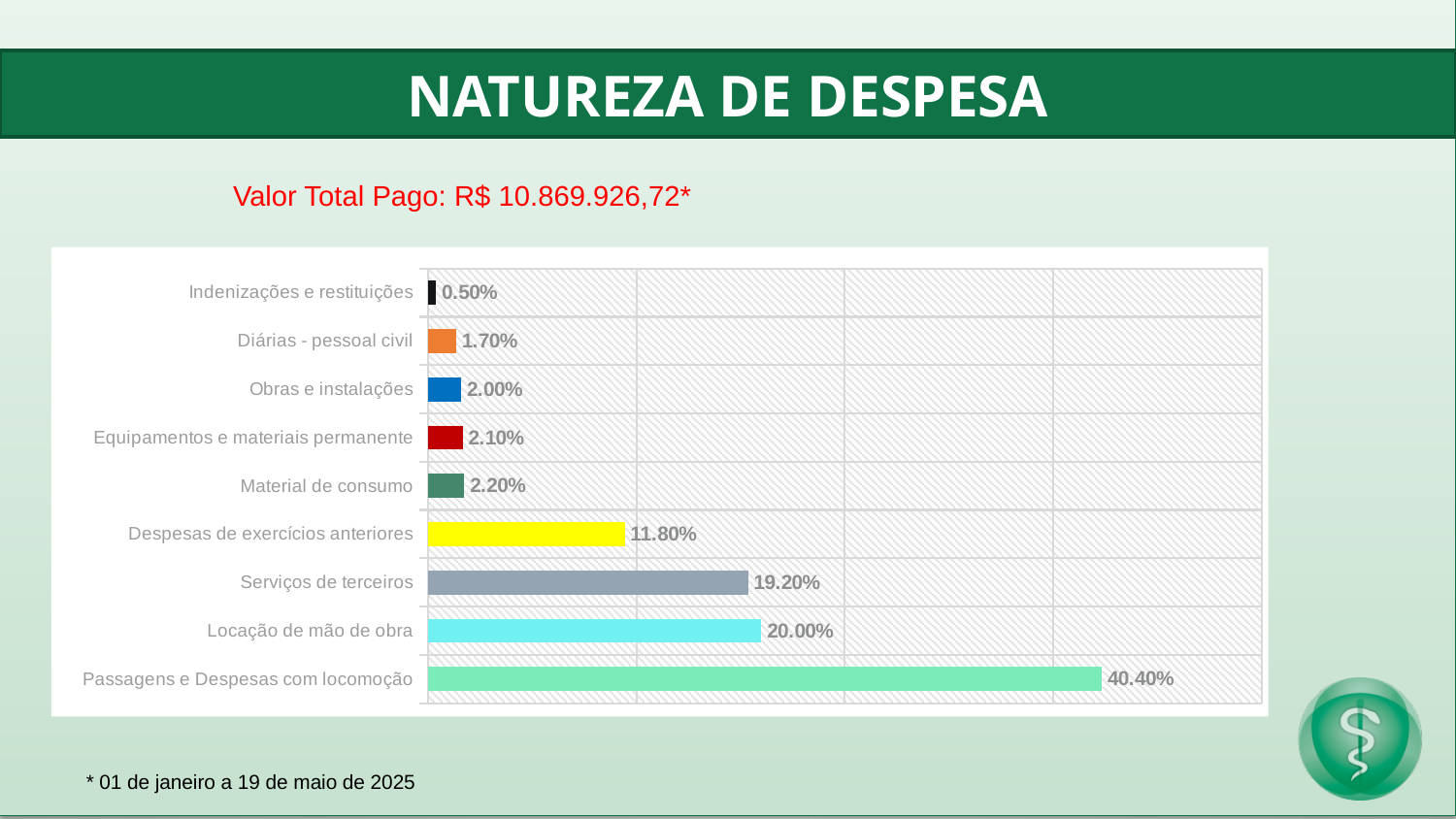
Which category has the highest value? Passagens e Despesas com locomoção How many categories are shown in the chart? 9 Which category has the lowest value? Indenizações e restituições Which is larger, Obras e instalações or Diárias - pessoal civil? Obras e instalações What kind of chart is shown on the slide? Bar chart What is the total paid value stated above the chart? R$ 10.869.926,72 What is the difference between Serviços de terceiros and Despesas de exercícios anteriores? 7.40% What is the value for Serviços de terceiros? 19.20% What is the value for Despesas de exercícios anteriores? 11.80% What is the difference between Passagens e Despesas com locomoção and Locação de mão de obra? 20.40% What is the value for Passagens e Despesas com locomoção? 40.40% What is the value for Indenizações e restituições? 0.50%